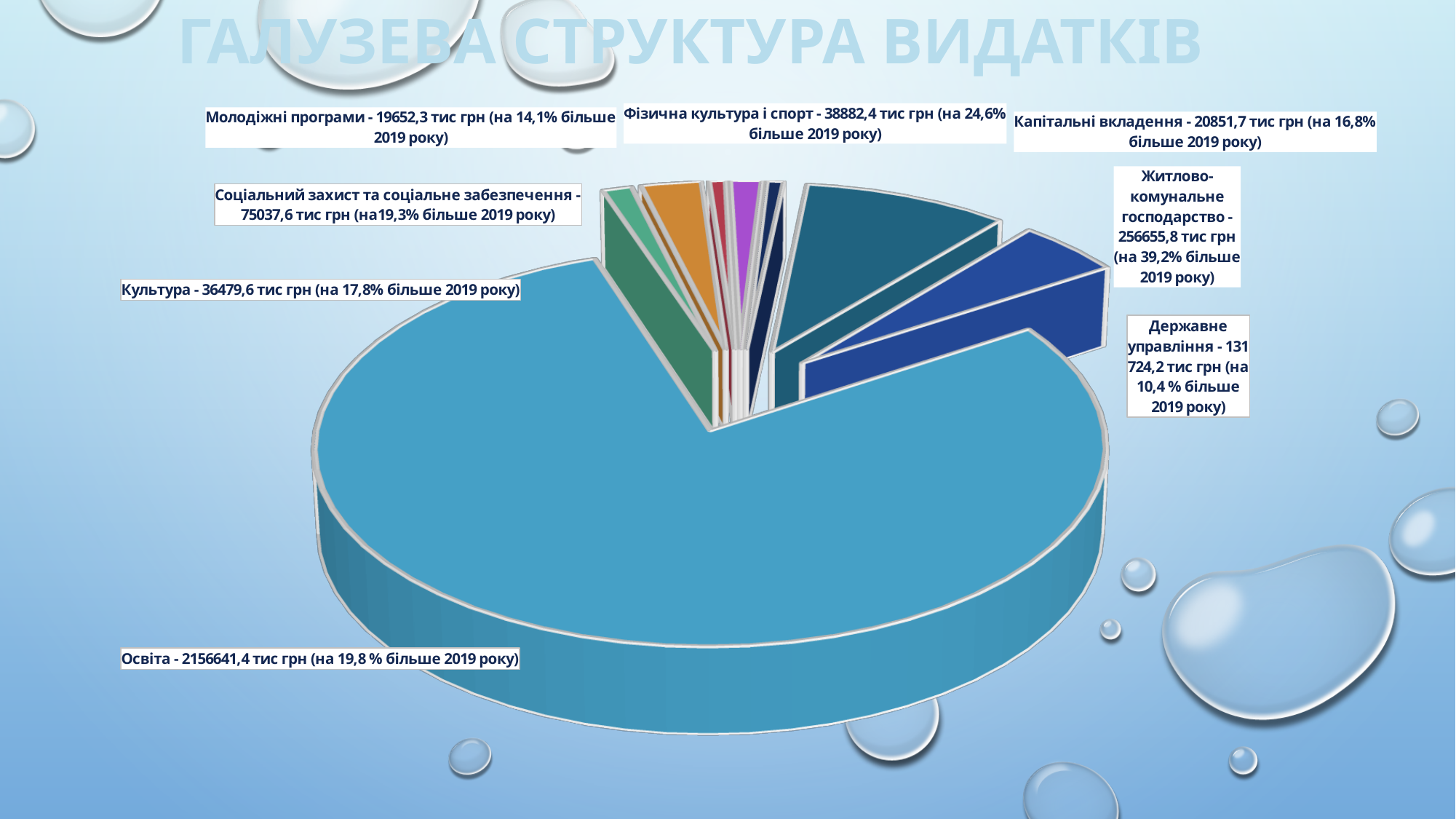
What is the difference between Фізична культура і спорт and Культура? 2402,8 тис грн Which is larger, Фізична культура і спорт or Культура? Фізична культура і спорт Which labelled category has the smallest value? Молодіжні програми By what percentage did Молодіжні програми grow compared to 2019? 14,1% By what percentage did Житлово-комунальне господарство grow compared to 2019? 39,2% What is the value for Державне управління? 131 724,2 тис грн What is the difference between Капітальні вкладення and Молодіжні програми? 1199,4 тис грн What is the value for Житлово-комунальне господарство? 256655,8 тис грн What kind of chart is shown on the slide? Pie chart What is the title of the chart on the slide? ГАЛУЗЕВА СТРУКТУРА ВИДАТКІВ Which category has the largest value? Освіта What is the value for Освіта? 2156641,4 тис грн